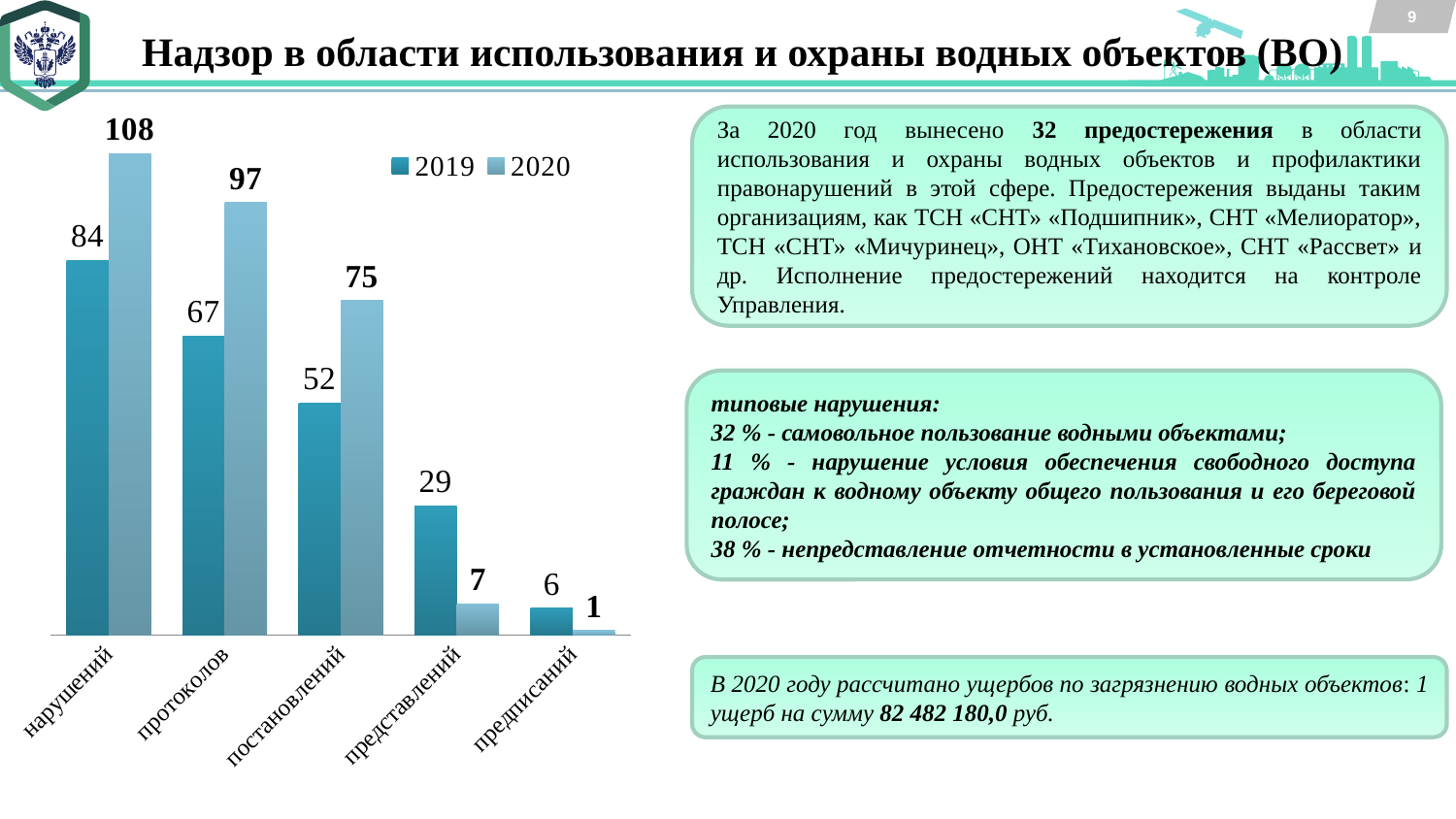
How many series does the chart legend list? 2 Which series is shown in the lighter blue colour in the chart? 2020 What is the value for "протоколов" in 2019? 67 Which category has the lowest value in the 2019 series? предписаний Which is larger for "представлений": the 2019 value or the 2020 value? 2019 What type of chart is shown on the slide? bar chart Which category has the highest value in the 2020 series? нарушений How many categories are shown on the x axis of the chart? 5 What is the value for "нарушений" in 2020? 108 What is the value for "предписаний" in 2019? 6 What is the value for "представлений" in 2020? 7 What is the difference between the 2020 and 2019 values for "постановлений"? 23